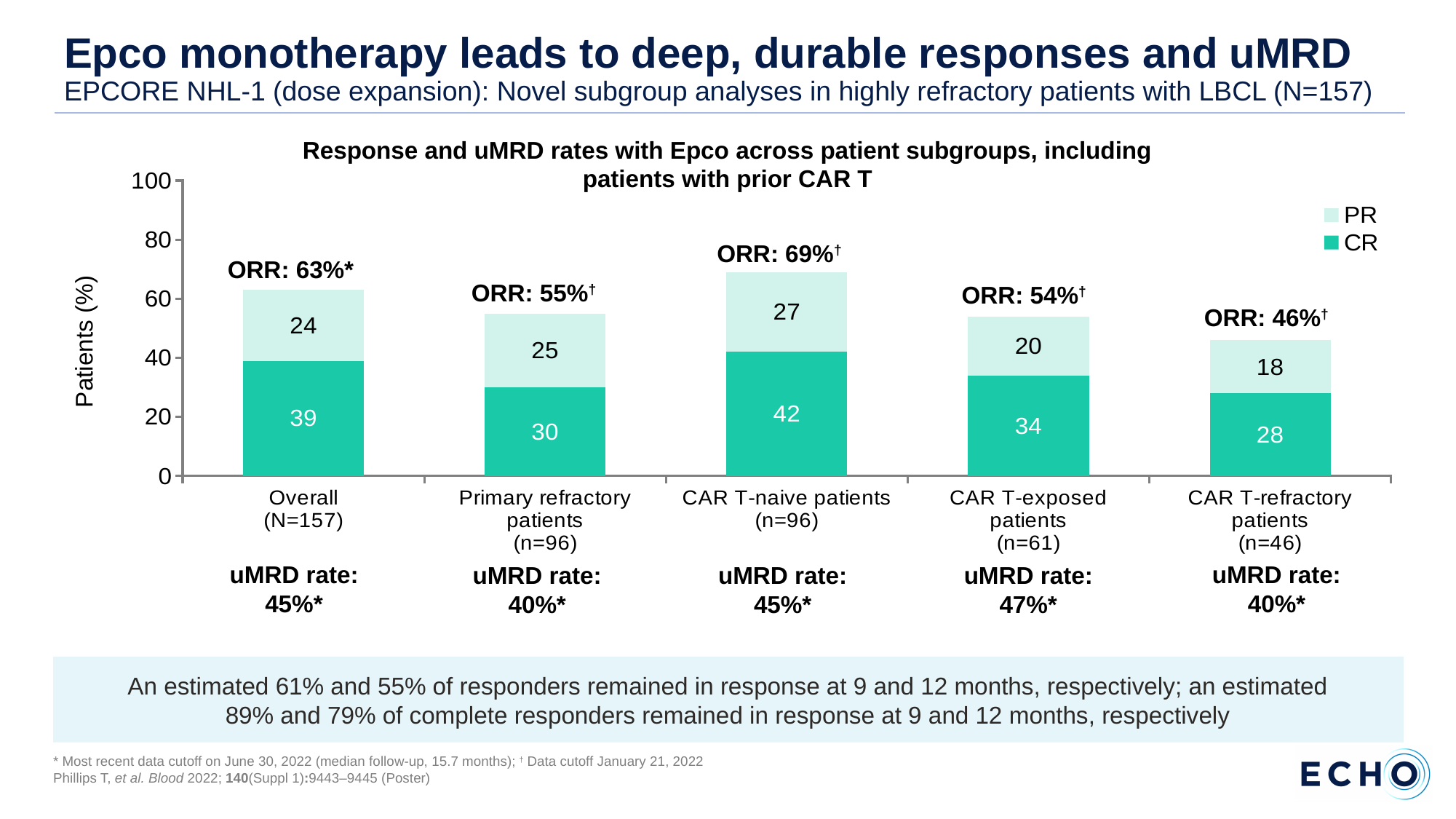
What kind of chart is shown on the slide? Stacked bar chart Which is larger: the PR value for CAR T-naive patients (n=96) or the PR value for CAR T-exposed patients (n=61)? CAR T-naive patients (n=96) Which category has the lowest PR value? CAR T-refractory patients (n=46) What is the difference between the CR value for Overall (N=157) and the CR value for CAR T-refractory patients (n=46)? 11 How many patient subgroup categories are shown on the x axis? 5 Which category has the highest CR value? CAR T-naive patients (n=96) What is the ORR shown above the bar for CAR T-exposed patients (n=61)? 54% What is the uMRD rate shown below the CAR T-exposed patients (n=61) bar? 47%* What is the PR value for Primary refractory patients (n=96)? 25 What is the CR value for CAR T-naive patients (n=96)? 42 How many series does the legend list? 2 What is the total of the stacked bar for Overall (N=157)? 63